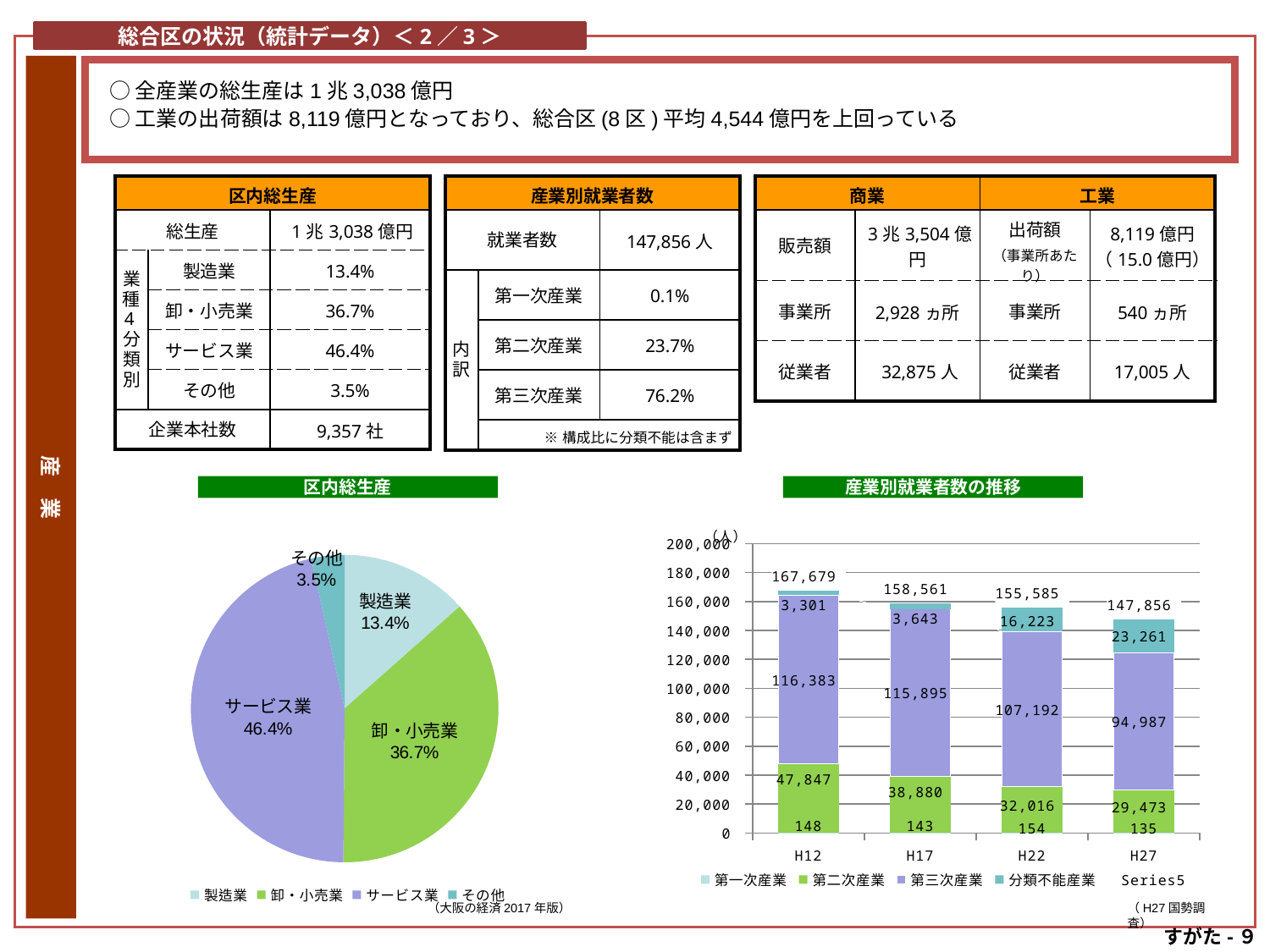
In the pie chart titled 区内総生産, which category has the smallest share? その他 In the pie chart titled 区内総生産, how many slices are there? 4 In the bar chart titled 産業別就業者数の推移, do the totals rise or fall from H12 to H27? fall In the bar chart titled 産業別就業者数の推移, what is the difference between the 第二次産業 values for H12 and H27? 18,374 In the bar chart titled 産業別就業者数の推移, is the 分類不能産業 value for H27 larger or smaller than the 分類不能産業 value for H12? larger In the pie chart titled 区内総生産, which category has the largest share? サービス業 In the pie chart titled 区内総生産, what share does サービス業 have? 46.4% In the bar chart titled 産業別就業者数の推移, which year has the lowest total? H27 In the bar chart titled 産業別就業者数の推移, how many entries does the legend list? 5 In the bar chart titled 産業別就業者数の推移, what is the value for 第三次産業 in H22? 107,192 In the bar chart titled 産業別就業者数の推移, what is the total of the stacked bar for H17? 158,561 What kind of chart is the chart titled 区内総生産? pie chart